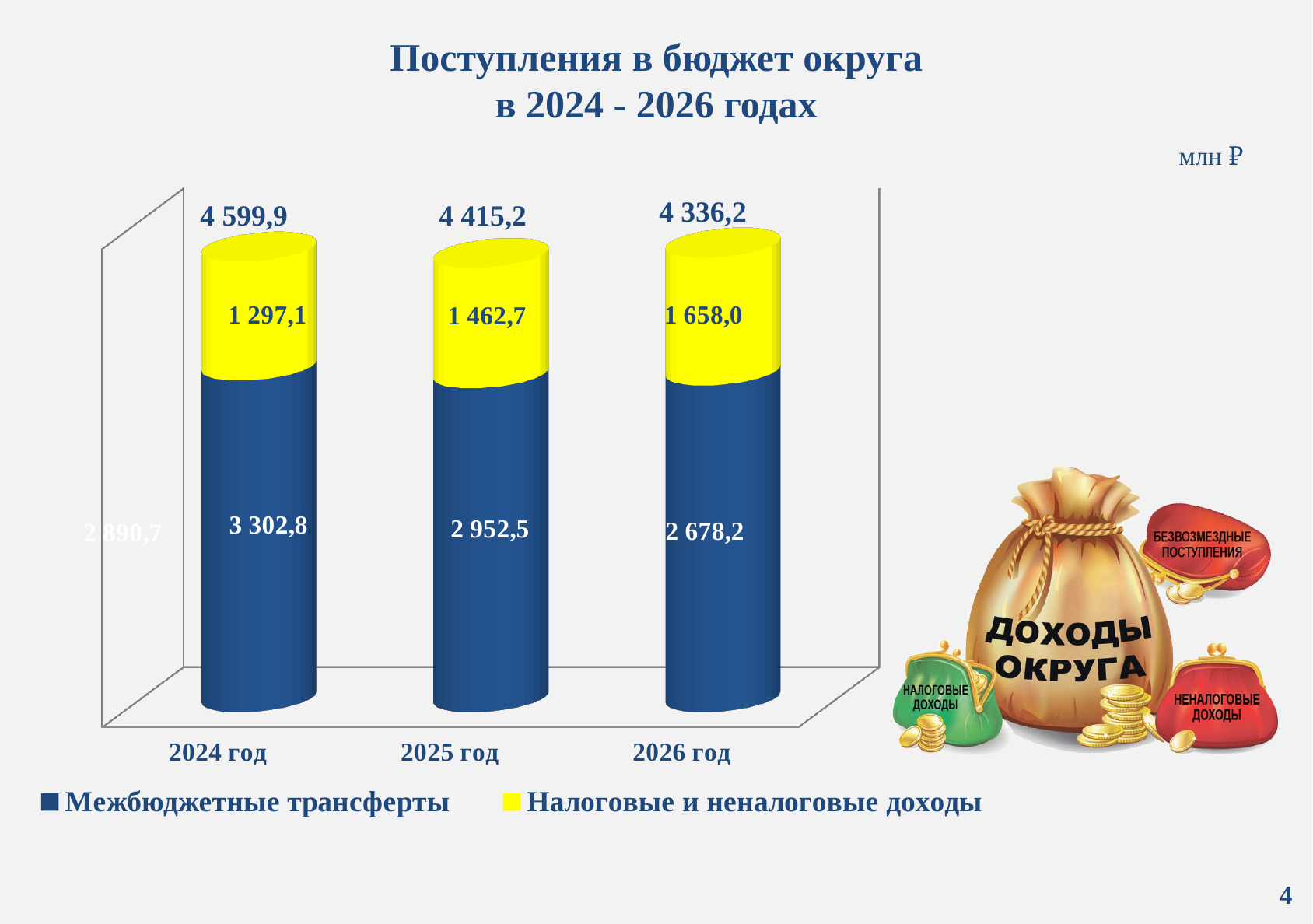
What is the value of Налоговые и неналоговые доходы for 2026 год? 1 658,0 Which year has the highest total budget receipts? 2024 год What kind of chart is shown on the slide? Stacked bar chart How many series does the legend list? 2 What is the value of Межбюджетные трансферты for 2024 год? 3 302,8 What is the difference between Межбюджетные трансферты in 2024 год and 2026 год? 624,6 What is the total of the stacked bar for 2025 год? 4 415,2 How many years (categories) are shown on the chart? 3 Which year has the lowest value for Межбюджетные трансферты? 2026 год Which is larger: Налоговые и неналоговые доходы in 2024 год or in 2026 год? 2026 год How do the values of Налоговые и неналоговые доходы change from 2024 год to 2026 год? They rise What is the value of Налоговые и неналоговые доходы for 2025 год? 1 462,7